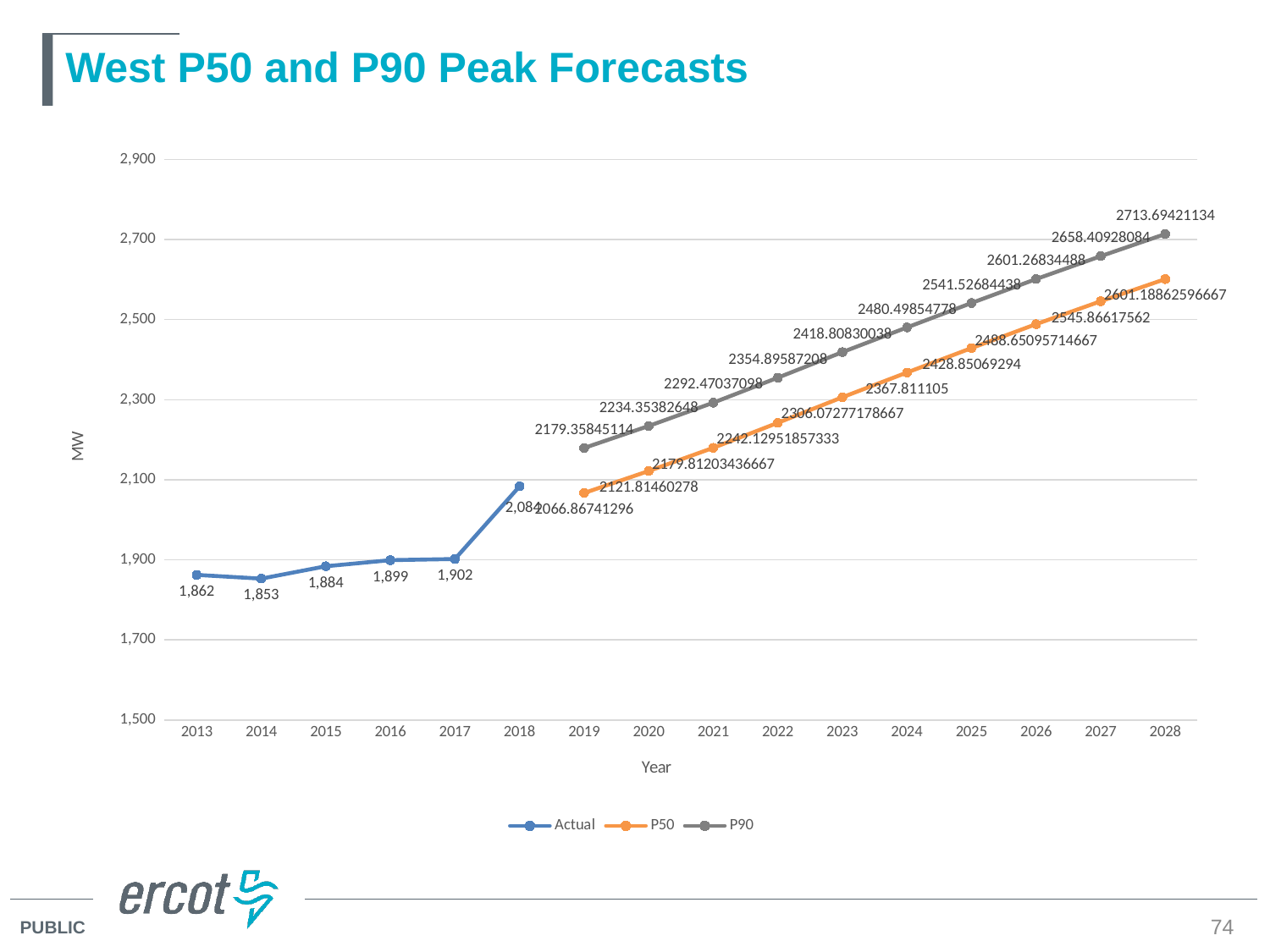
What is the P50 value for 2024? 2367.811105 What is the Actual value for 2013? 1,862 Which is larger in 2019, the P50 value or the P90 value? P90 What is the difference between the Actual values for 2016 and 2015? 15 How many series does the legend list? 3 In which year is the Actual series lowest? 2014 Does the P50 series rise or fall from 2019 to 2028? rises What is the P90 value for 2028? 2713.69421134 In which year is the Actual series highest? 2018 How many years are shown on the x axis? 16 What is the Actual value for 2017? 1,902 What kind of chart is shown on the slide? line chart